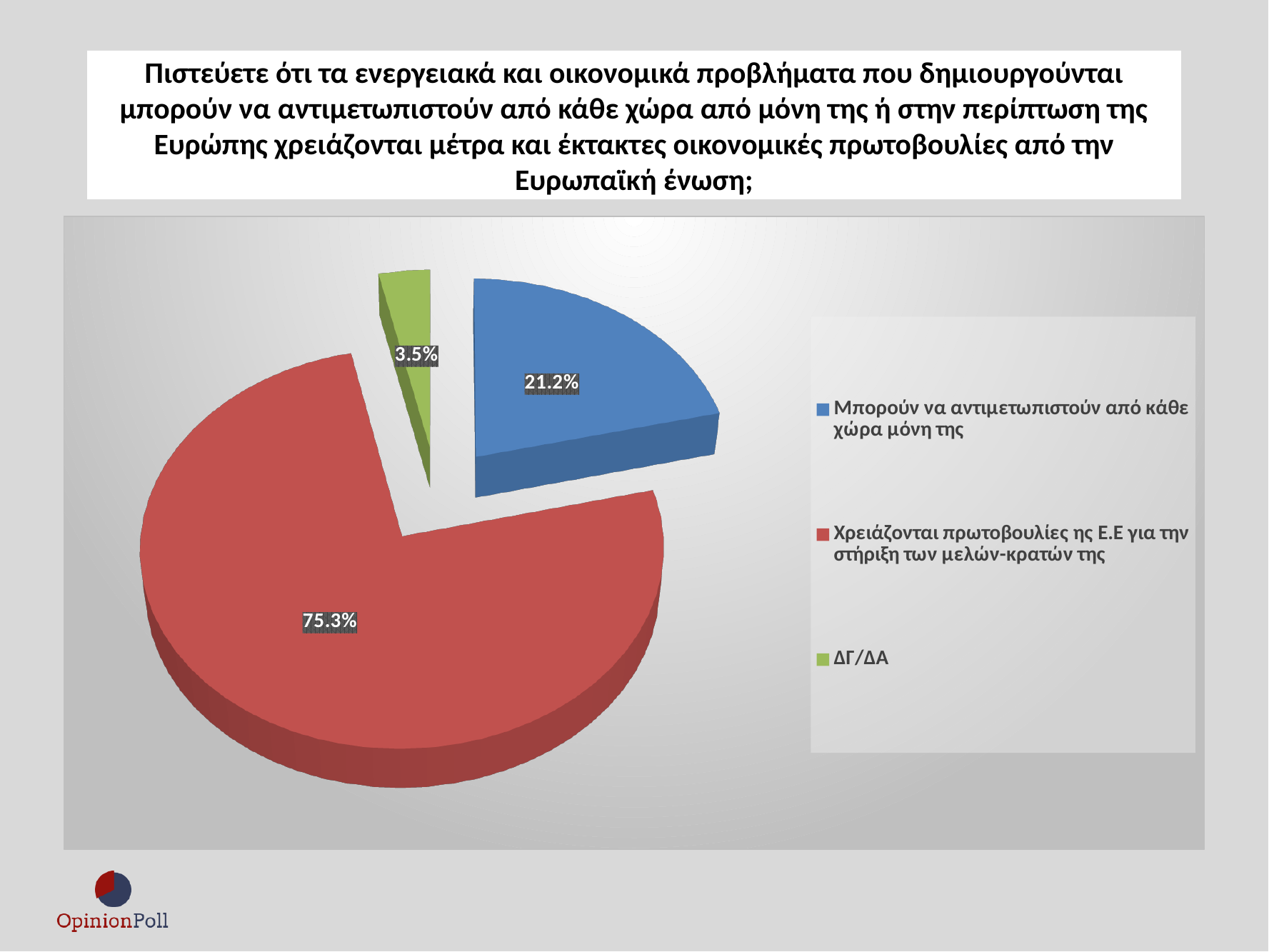
What is the difference in percentage points between the "Χρειάζονται πρωτοβουλίες ης Ε.Ε" slice and the "Μπορούν να αντιμετωπιστούν από κάθε χώρα μόνη της" slice? 54.1 What share of the pie is labelled "Χρειάζονται πρωτοβουλίες ης Ε.Ε για την στήριξη των μελών-κρατών της"? 75.3% Which category has the largest slice of the pie? Χρειάζονται πρωτοβουλίες ης Ε.Ε για την στήριξη των μελών-κρατών της What kind of chart is shown on the slide? Pie chart How many entries does the legend list? 3 How many slices does the pie chart have? 3 Which is larger: the "Μπορούν να αντιμετωπιστούν από κάθε χώρα μόνη της" slice or the "ΔΓ/ΔΑ" slice? Μπορούν να αντιμετωπιστούν από κάθε χώρα μόνη της What share of the pie is labelled "Μπορούν να αντιμετωπιστούν από κάθε χώρα μόνη της"? 21.2% What colour is the slice representing "Μπορούν να αντιμετωπιστούν από κάθε χώρα μόνη της"? Blue Which category has the smallest slice of the pie? ΔΓ/ΔΑ What share of the pie is labelled "ΔΓ/ΔΑ"? 3.5% What colour is the slice representing "ΔΓ/ΔΑ"? Green